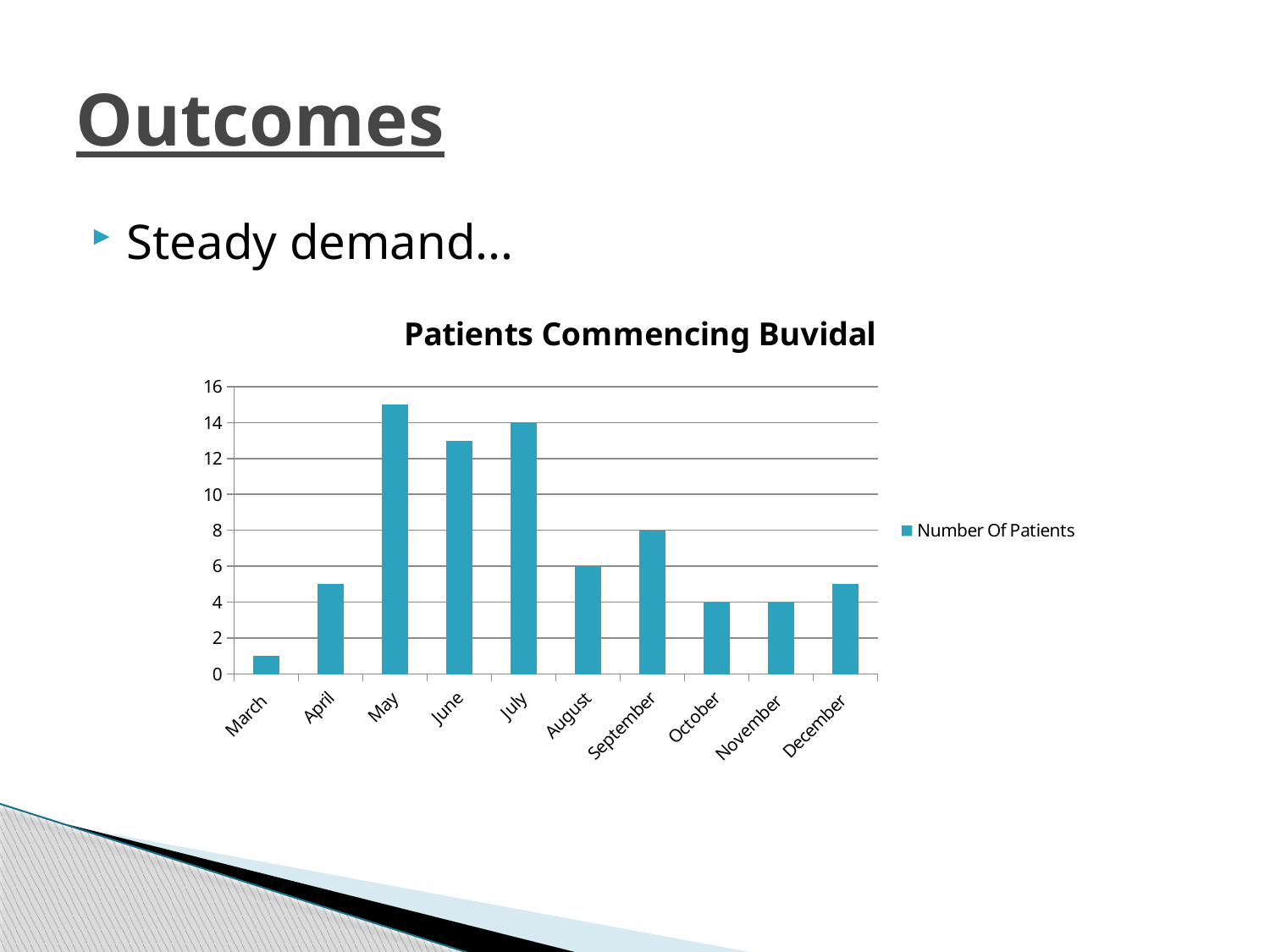
Is the value for March greater or less than 2? less Which month has the lowest number of patients? March What is the difference between the number of patients in July and August? 8 What is the number of patients for July? 14 What is the number of patients for September? 8 What type of chart is shown on the slide? bar chart How many series does the legend list? 1 What is the title of the chart? Patients Commencing Buvidal How many months are shown on the x axis of the chart? 10 Which is larger, the value for May or the value for June? May Is the value for May greater or less than 14? greater Which month has the highest number of patients? May